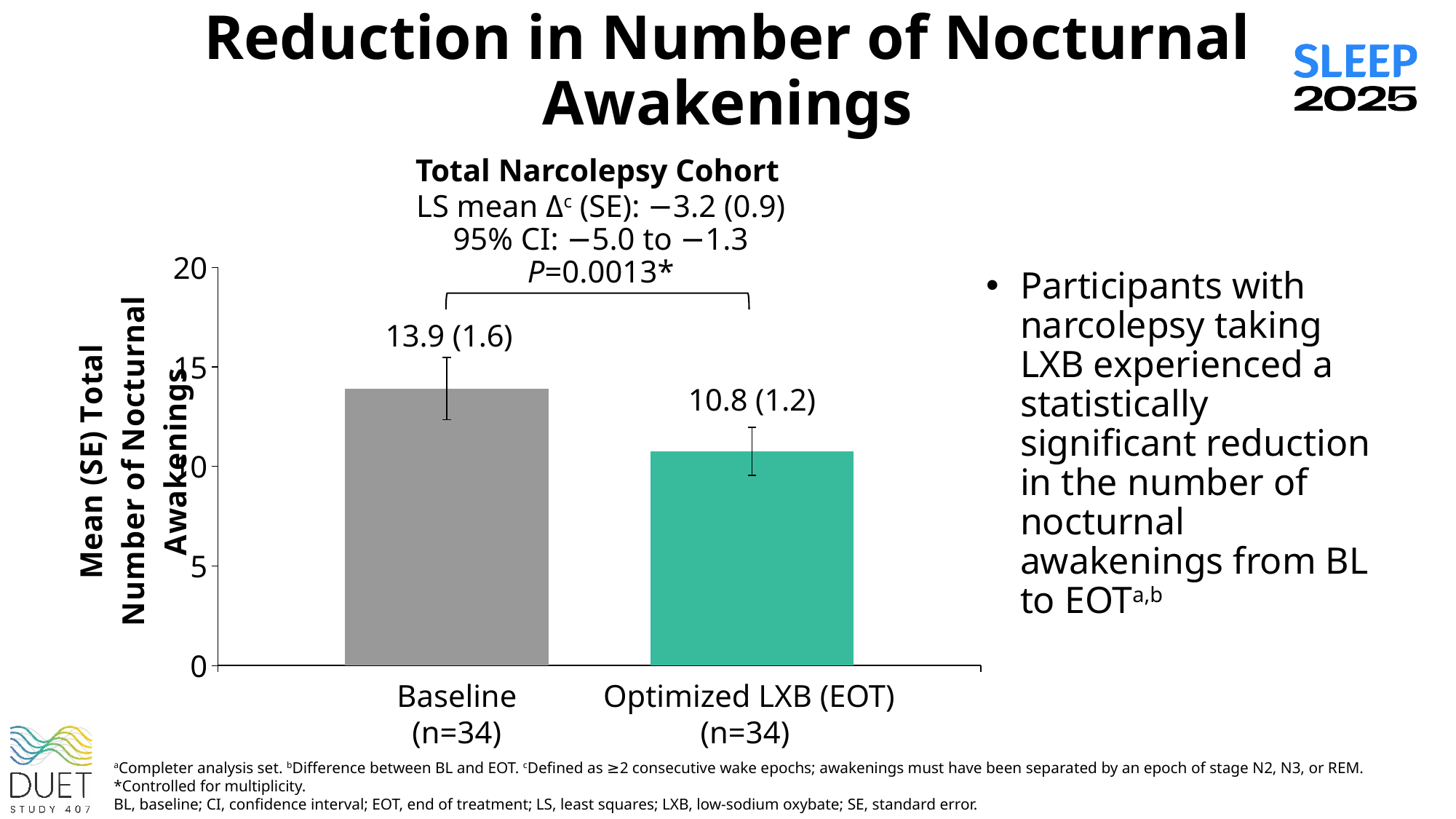
What kind of chart is shown on the slide? Bar chart Which category has the lowest mean number of nocturnal awakenings? Optimized LXB (EOT) What is the LS mean change (SE) shown above the chart for the Total Narcolepsy Cohort? −3.2 (0.9) What is the mean (SE) total number of nocturnal awakenings for Optimized LXB (EOT)? 10.8 (1.2) How many categories are shown on the x axis of the chart? 2 What is the mean (SE) total number of nocturnal awakenings at Baseline? 13.9 (1.6) Is the mean number of nocturnal awakenings at Baseline greater or less than 10? greater Is the mean number of nocturnal awakenings for Optimized LXB (EOT) greater or less than 15? less Which category has the higher mean number of nocturnal awakenings, Baseline or Optimized LXB (EOT)? Baseline What is the P value shown above the chart? P=0.0013* Do the values rise or fall from Baseline to Optimized LXB (EOT)? Fall What is the difference between the Baseline mean (13.9) and the Optimized LXB (EOT) mean (10.8) of nocturnal awakenings? 3.1